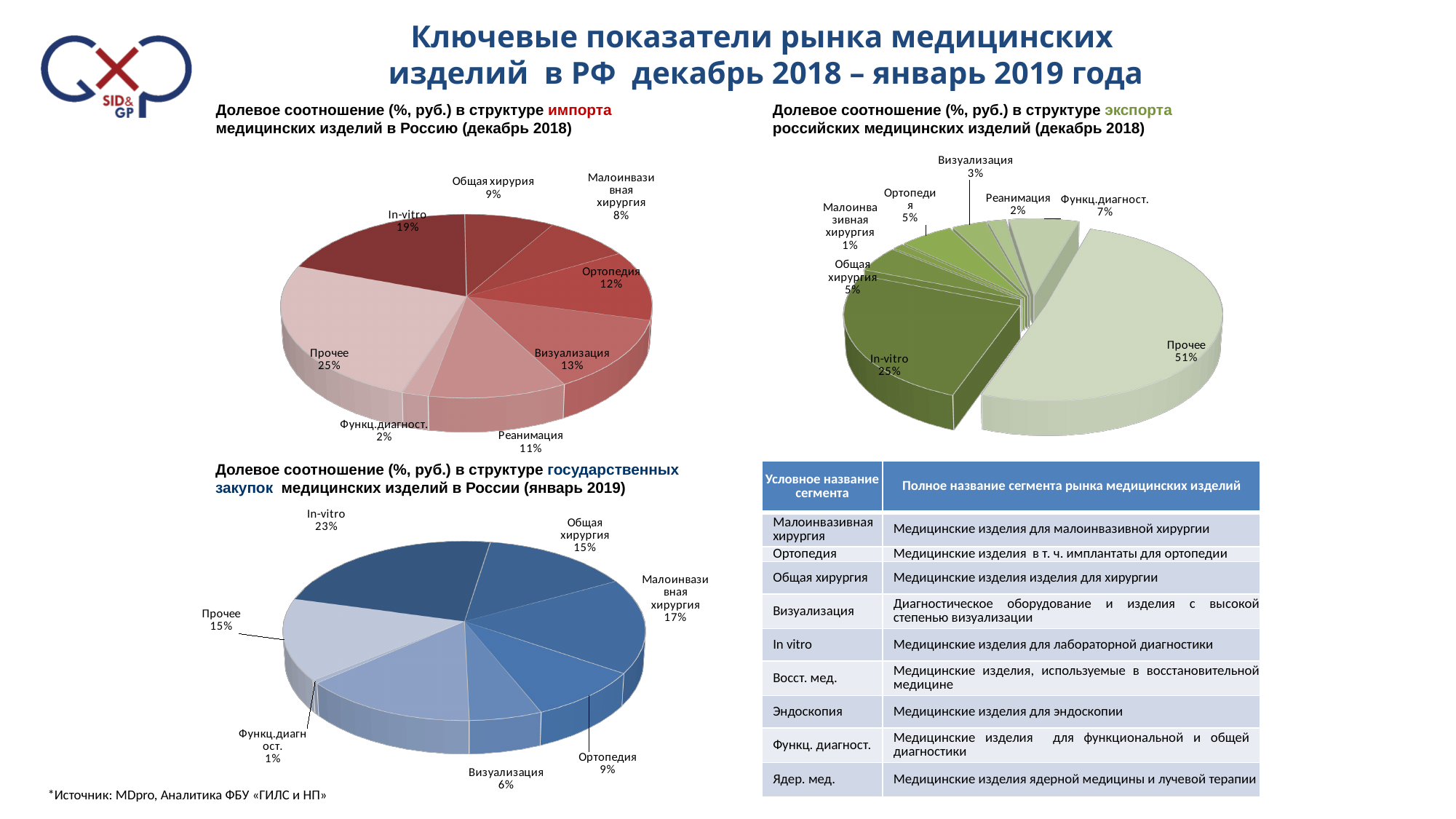
In the import structure pie chart (top left), what share does In-vitro have? 19% In the government procurement pie chart (bottom left), which segment has the largest share? In-vitro What type of chart is used for the import structure (top left)? Pie chart In the import structure pie chart (top left), what is the difference between the shares of Визуализация and Ортопедия? 1% In the import structure pie chart (top left), which segment has the largest share? Прочее In the import structure pie chart (top left), which segment has the smallest share? Функц.диагност. In the export structure pie chart (top right), how many segments are shown? 8 In the government procurement pie chart (bottom left), what is the difference between the shares of In-vitro and Ортопедия? 14% In the export structure pie chart (top right), what share does Прочее have? 51% In the government procurement pie chart (bottom left), what share does Малоинвазивная хирургия have? 17% In the export structure pie chart (top right), which is larger: Функц.диагност. or Ортопедия? Функц.диагност. In the export structure pie chart (top right), which segment has the smallest share? Малоинвазивная хирургия